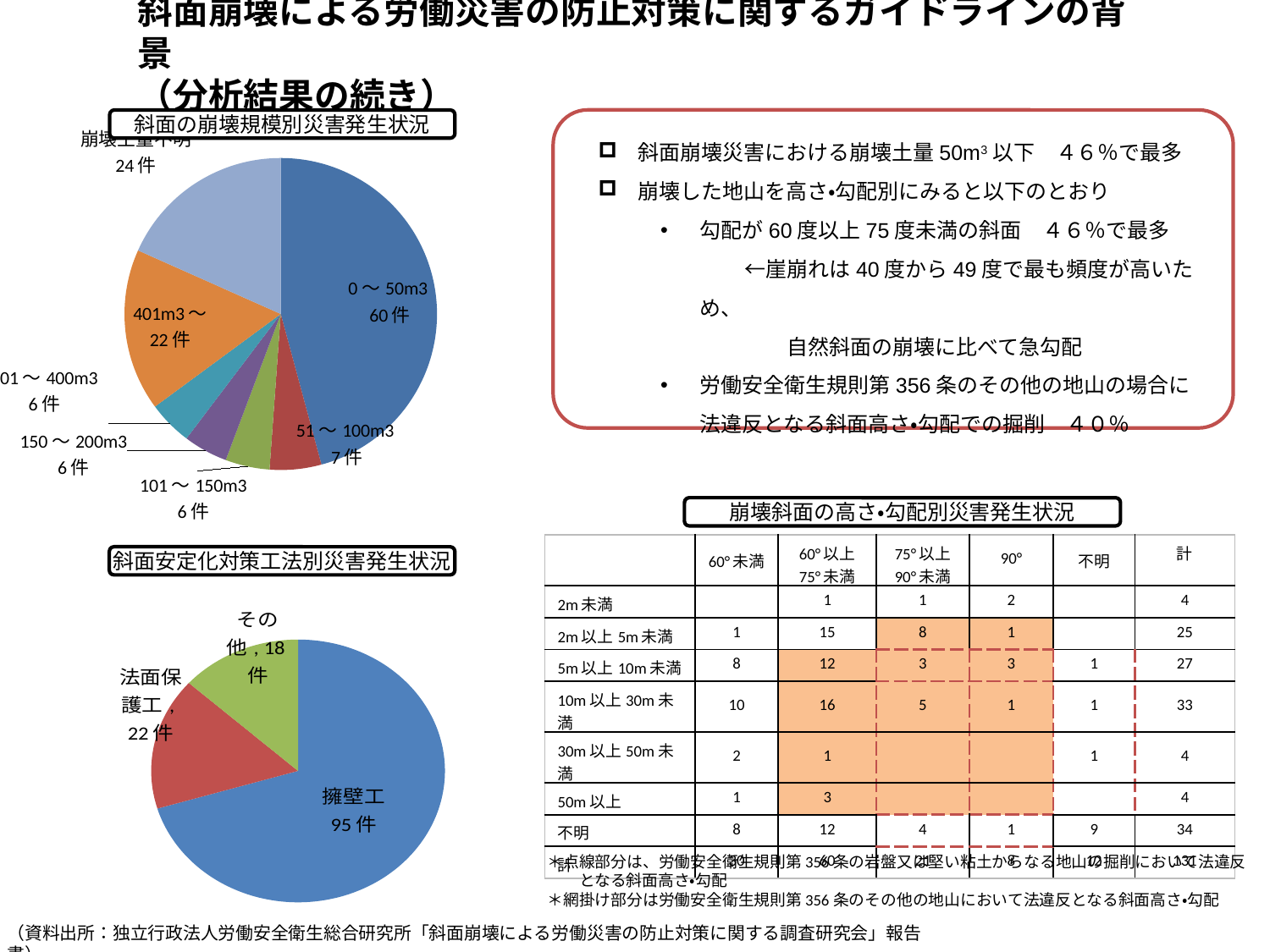
In the pie chart titled 斜面安定化対策工法別災害発生状況, how many cases are attributed to 擁壁工? 95件 In the pie chart titled 斜面の崩壊規模別災害発生状況, what is the difference in cases between 0～50m3 and 401m3～? 38件 In the pie chart titled 斜面安定化対策工法別災害発生状況, how many categories are shown? 3 In the pie chart titled 斜面の崩壊規模別災害発生状況, how many cases are in the 51～100m3 category? 7件 In the pie chart titled 斜面安定化対策工法別災害発生状況, what is the difference in cases between 擁壁工 and 法面保護工? 73件 In the pie chart titled 斜面安定化対策工法別災害発生状況, how many cases are attributed to 法面保護工? 22件 What type of chart is used for 斜面安定化対策工法別災害発生状況? Pie chart In the pie chart titled 斜面の崩壊規模別災害発生状況, which has more cases, 51～100m3 or 101～150m3? 51～100m3 In the pie chart titled 斜面安定化対策工法別災害発生状況, which category has the fewest cases? その他 In the pie chart titled 斜面の崩壊規模別災害発生状況, how many cases are in the 401m3～ category? 22件 In the pie chart titled 斜面の崩壊規模別災害発生状況, how many cases are in the 0～50m3 category? 60件 In the pie chart titled 斜面の崩壊規模別災害発生状況, which category has the largest number of cases? 0～50m3